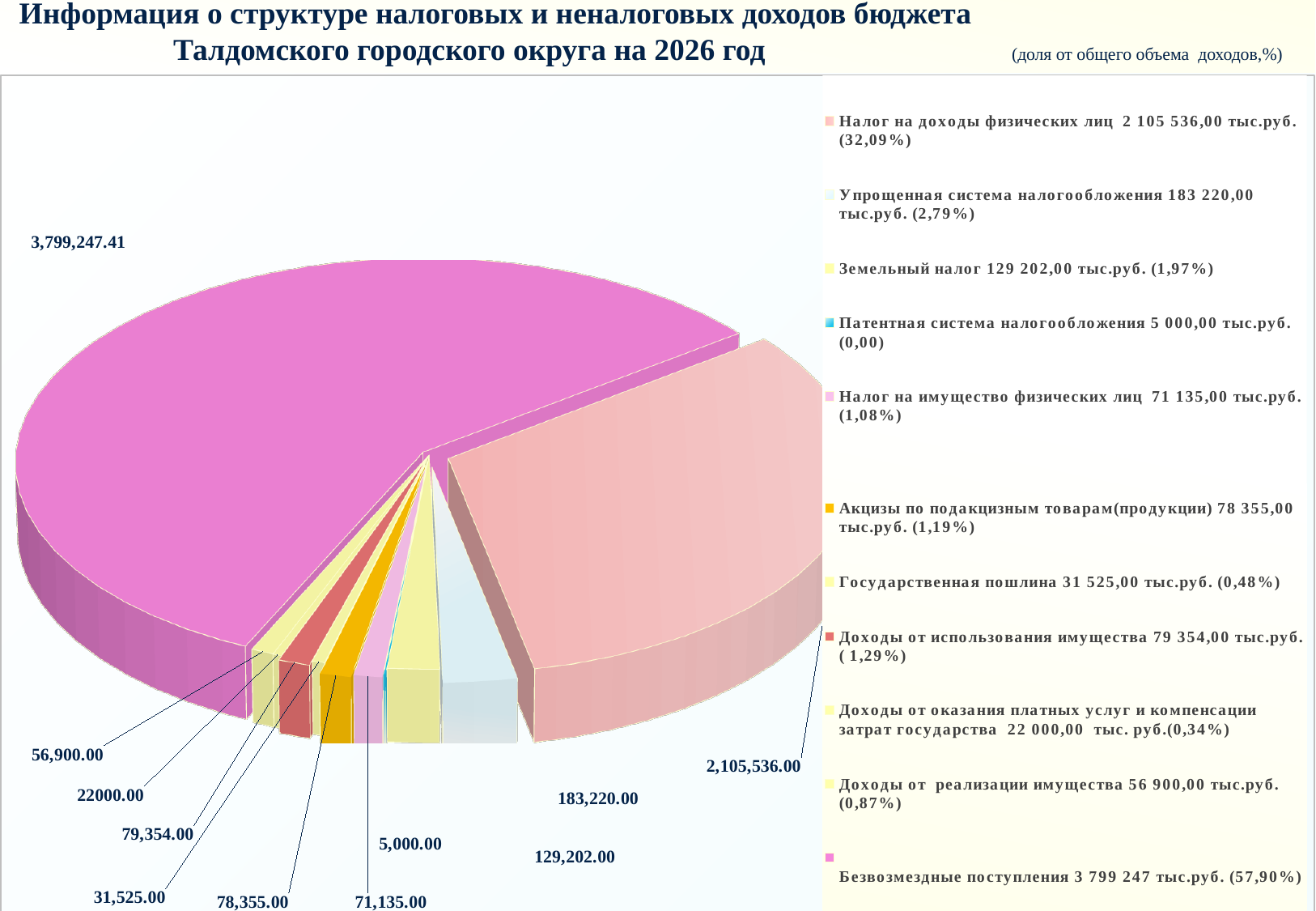
Which category has the smallest slice of the pie? Патентная система налогообложения What share of total revenue does Земельный налог represent according to the legend? 1,97% What is the difference between the values for Упрощенная система налогообложения and Земельный налог? 54,018.00 What is the data label value for Государственная пошлина? 31,525.00 What is the data label value for Налог на доходы физических лиц? 2,105,536.00 What kind of chart is shown on the slide? Pie chart What share of total revenue does Безвозмездные поступления represent according to the legend? 57,90% Which is larger: Доходы от использования имущества or Акцизы по подакцизным товарам(продукции)? Доходы от использования имущества What colour is the slice for Безвозмездные поступления? Pink/magenta Which category has the largest slice of the pie? Безвозмездные поступления What is the data label value for Упрощенная система налогообложения? 183,220.00 How many slices does the pie chart have? 11